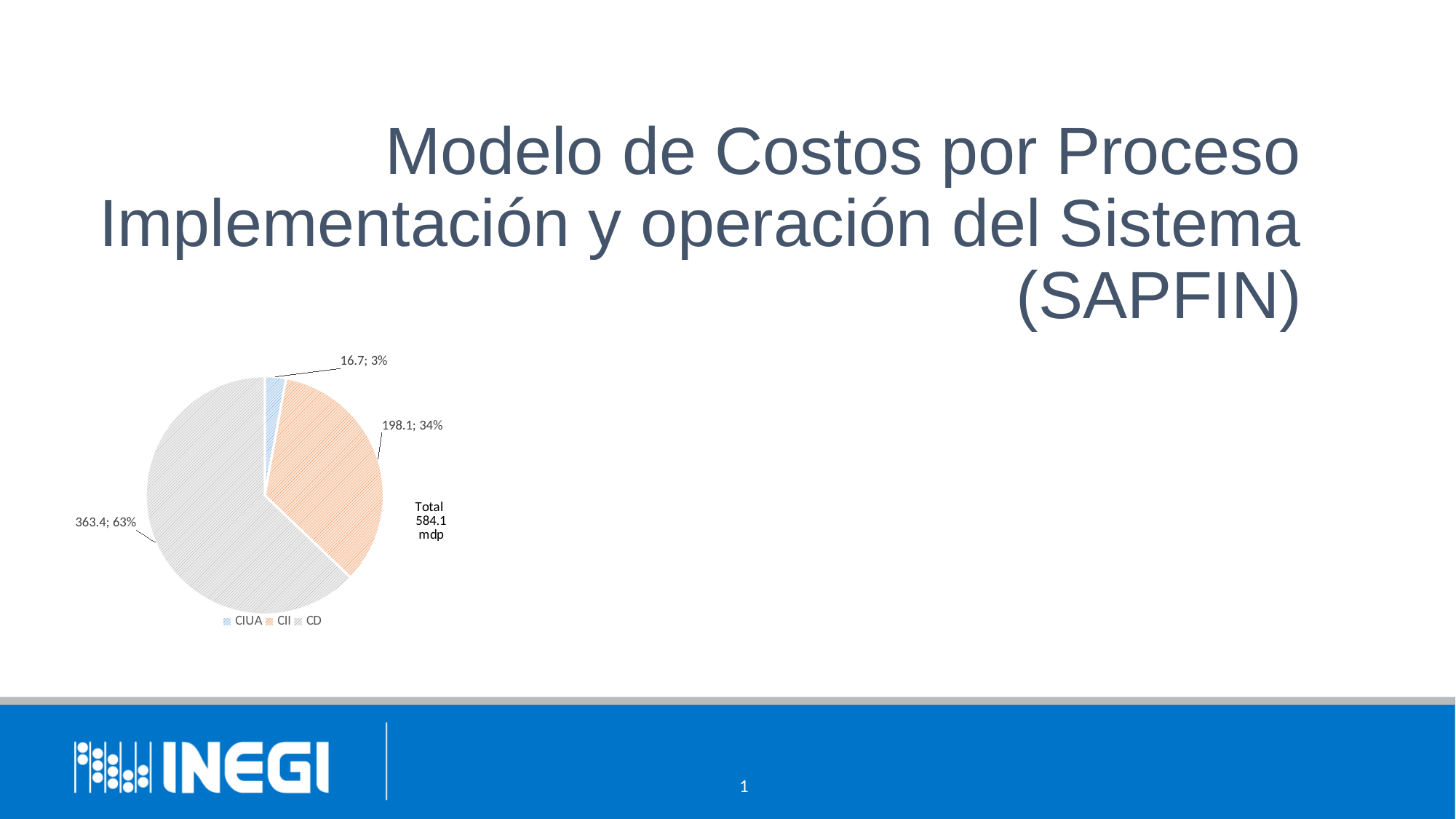
Which category has the largest slice in the pie chart? CD How many entries does the legend of the pie chart list? 3 What is the value shown for the CII slice of the pie chart? 198.1 What is the value shown for the CD slice of the pie chart? 363.4 What total is printed next to the pie chart? 584.1 mdp Which category has the smallest slice in the pie chart? CIUA How many slices does the pie chart have? 3 What is the value shown for the CIUA slice of the pie chart? 16.7 What is the difference between the CD value and the CII value in the pie chart? 165.3 What share of the pie does the CD slice represent? 63% What kind of chart is shown on the slide? pie chart What share of the pie does the CII slice represent? 34%